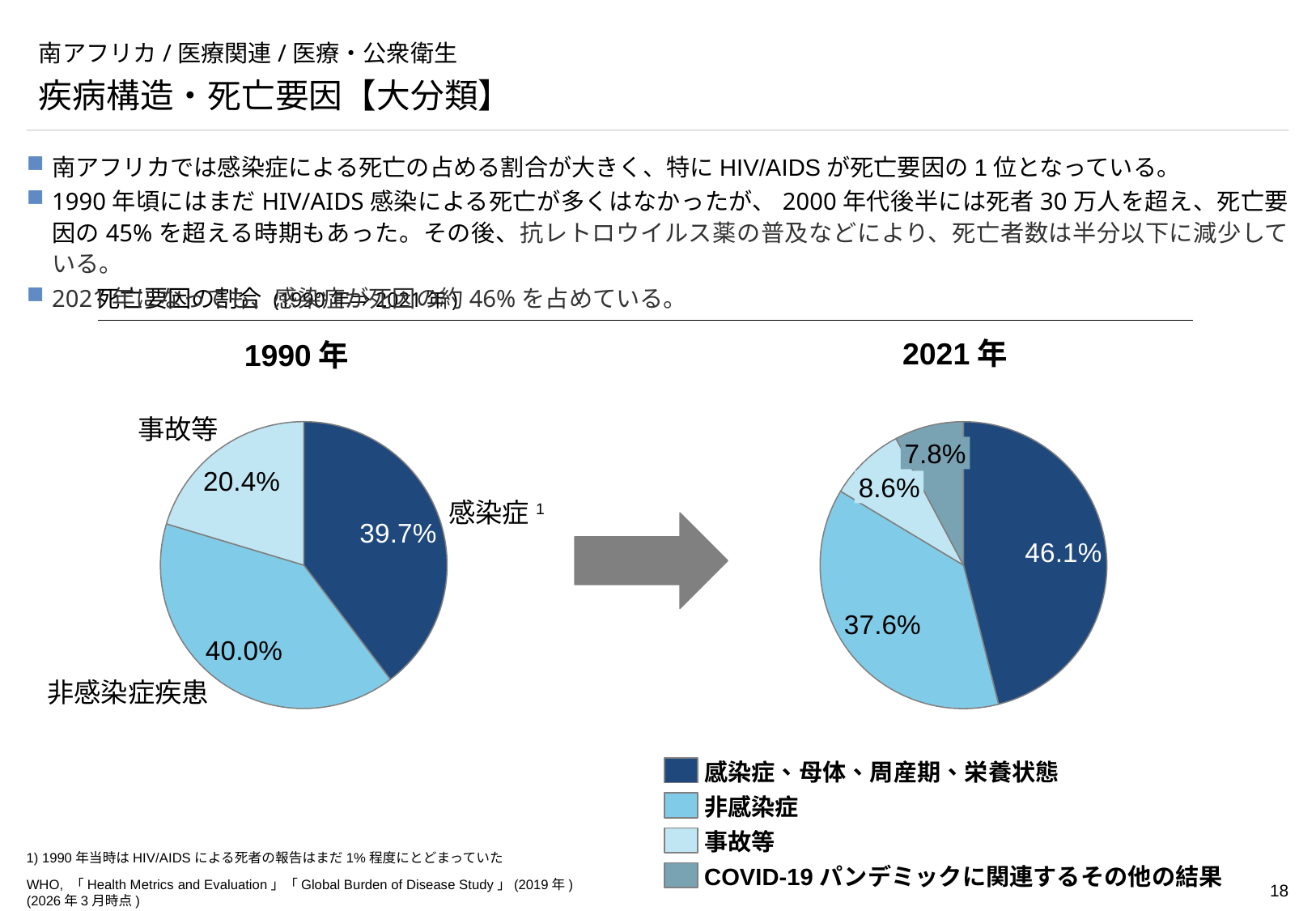
In the 2021年 pie chart, which category has the smallest share? COVID-19 パンデミックに関連するその他の結果 In the 2021年 pie chart, what share is shown for the 事故等 slice? 8.6% How many slices does the 2021年 pie chart have? 4 In the 1990年 pie chart, what share of deaths is attributed to 感染症? 39.7% In the 1990年 pie chart, what share of deaths is attributed to 非感染症疾患? 40.0% In the 1990年 pie chart, what share of deaths is attributed to 事故等? 20.4% In the 2021年 pie chart, what share is shown for the 感染症、母体、周産期、栄養状態 slice? 46.1% In the 2021年 pie chart, what share is shown for the COVID-19 パンデミックに関連するその他の結果 slice? 7.8% What is the difference between the 感染症 share in the 2021年 chart (46.1%) and in the 1990年 chart (39.7%)? 6.4 percentage points How many entries does the legend list? 4 In the 1990年 pie chart, which category has the smallest share? 事故等 In the 2021年 pie chart, which category has the largest share? 感染症、母体、周産期、栄養状態